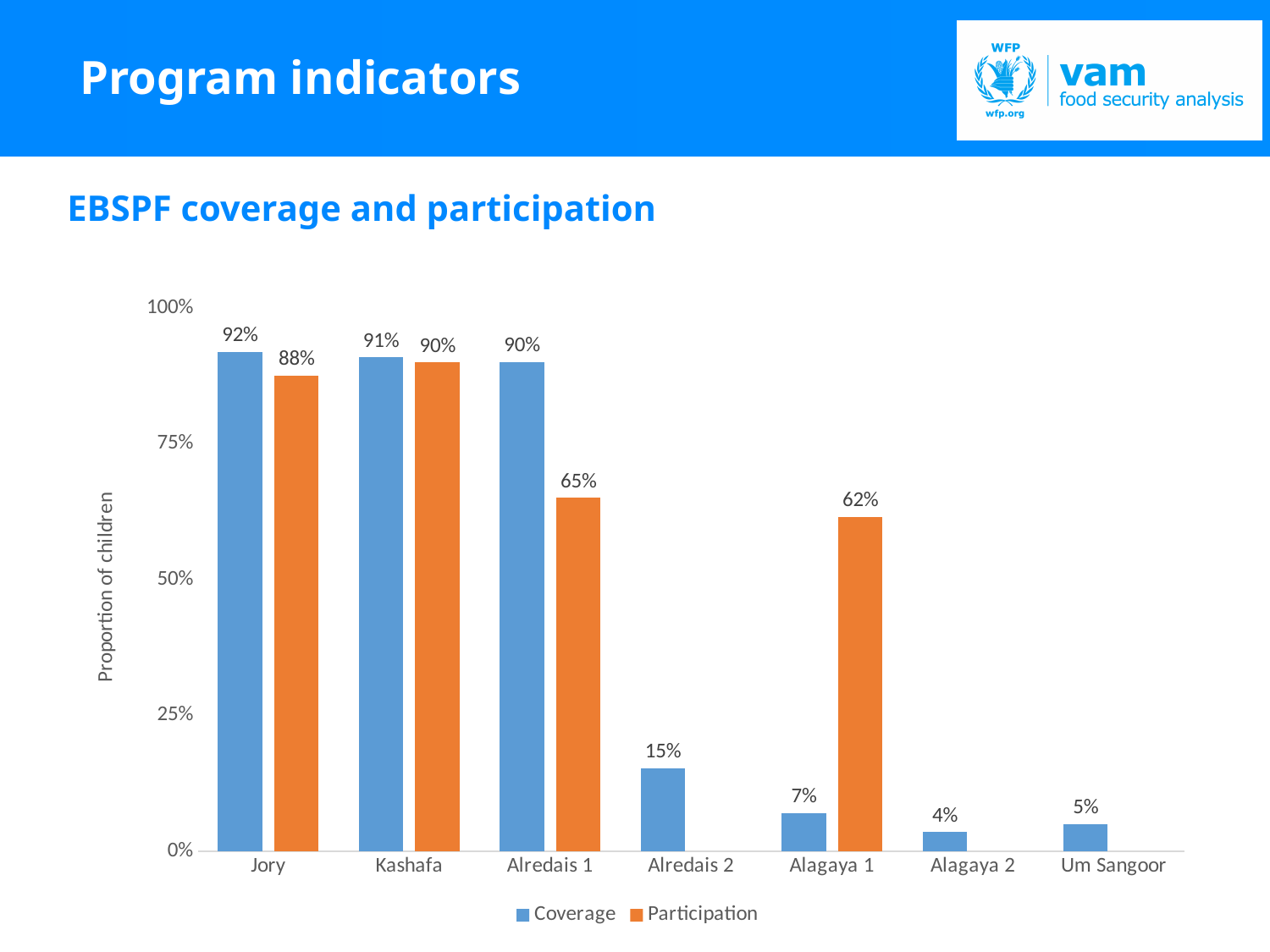
What kind of chart is shown on the slide? bar chart How many series does the legend list? 2 What is the label of the vertical axis? Proportion of children Is the Coverage value for Alredais 2 greater or less than 25%? less What is the Participation value for Alredais 1? 65% How many categories are shown on the x axis? 7 Which category has the lowest Coverage value? Alagaya 2 What is the Coverage value for Jory? 92% What is the Participation value for Alagaya 1? 62% Which category has the highest Coverage value? Jory Which is larger for Kashafa, Coverage or Participation? Coverage What is the difference between the Coverage and Participation values for Alredais 1? 25%